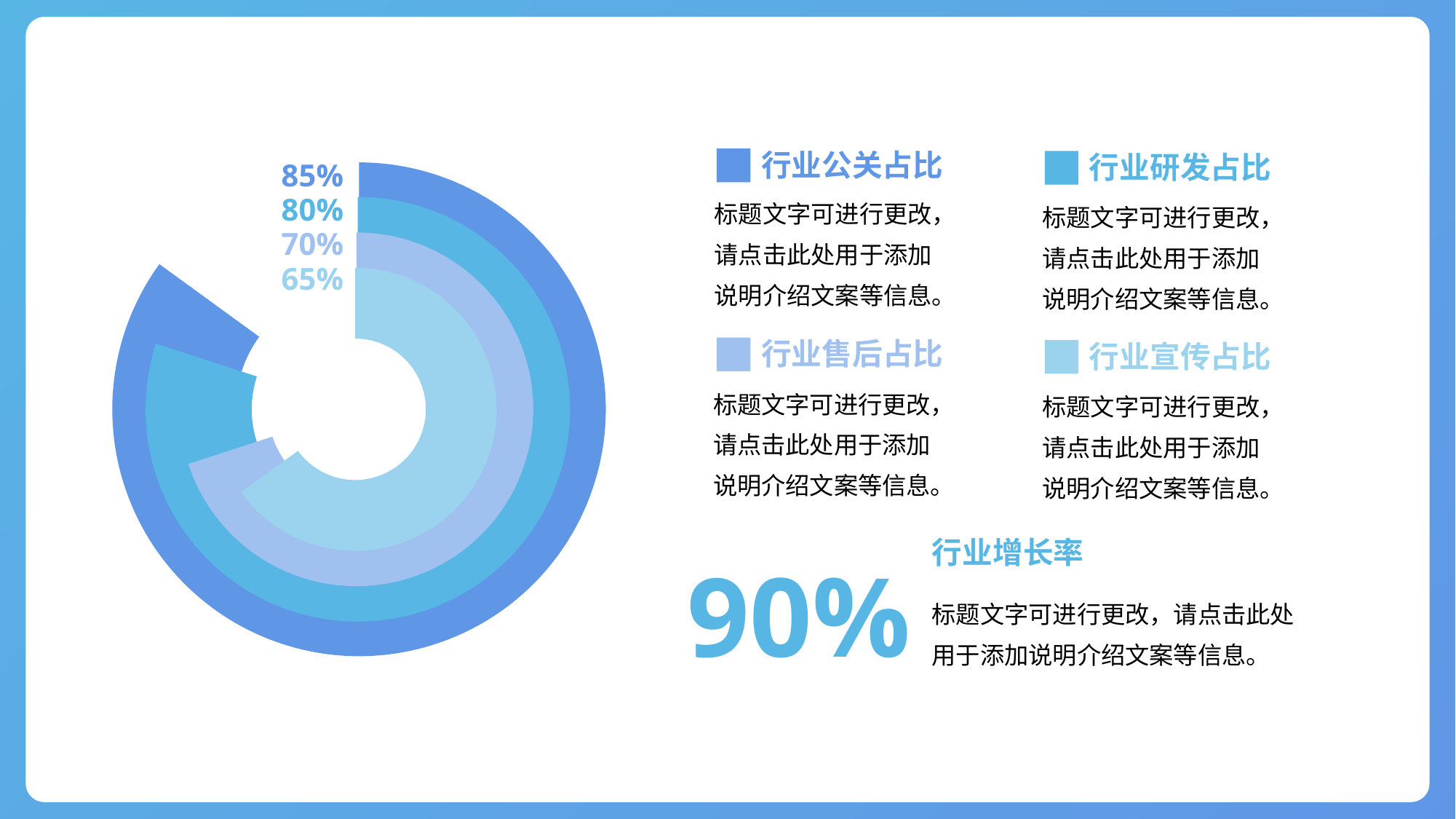
What is the value shown for 行业售后占比? 70% What is the difference between the values for 行业研发占比 and 行业售后占比? 10 percentage points What is the value shown for 行业公关占比? 85% Which category has the lowest value in the ring chart? 行业宣传占比 How many entries does the legend list? 4 Which category is represented by the outermost ring of the chart? 行业公关占比 What is the value shown for 行业研发占比? 80% Which is larger, the value for 行业研发占比 or the value for 行业售后占比? 行业研发占比 What is the difference between the values for 行业公关占比 and 行业宣传占比? 20 percentage points Which category has the highest value in the ring chart? 行业公关占比 How many categories are plotted in the ring chart? 4 What is the value shown for 行业宣传占比? 65%